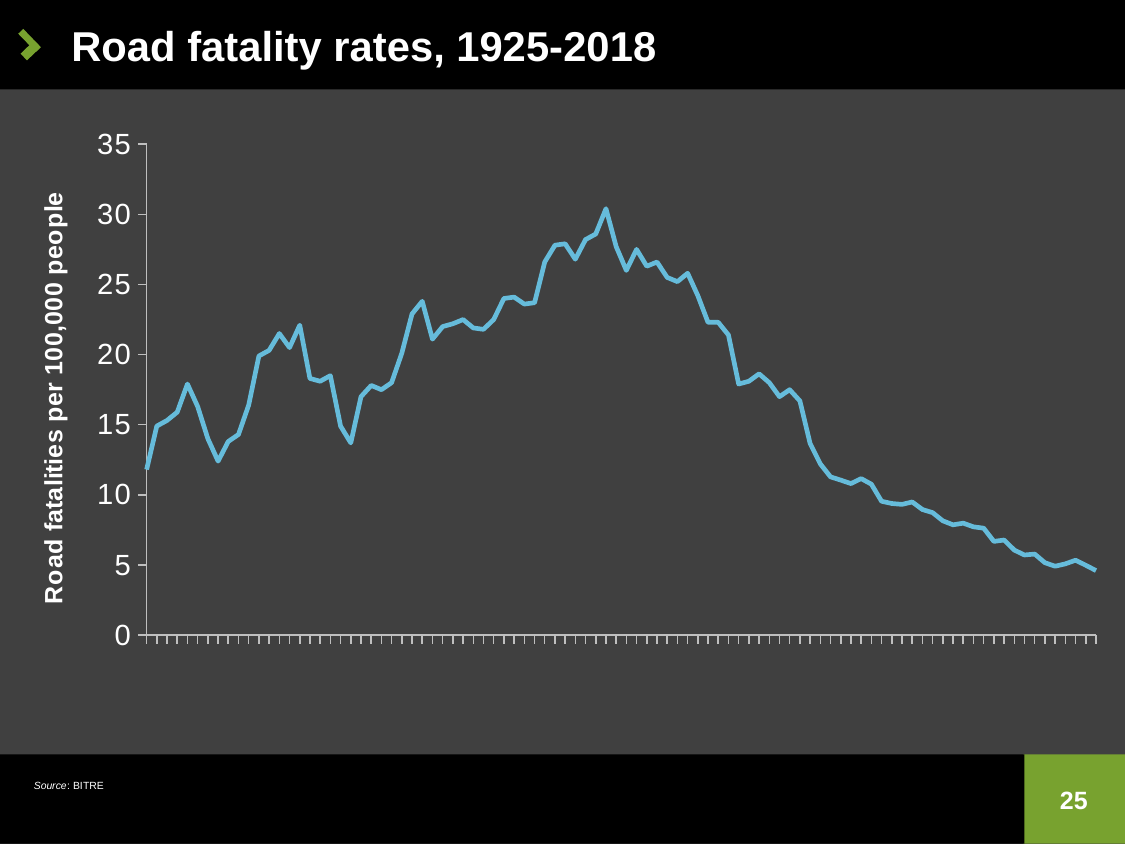
After reaching its peak, do the values along the x axis rise or fall towards the end of the series? fall Does the line end higher or lower than it starts? lower Is the value at the end of the series (2018) greater or less than 10? less Is the highest value reached by the line greater or less than 25? greater What kind of chart is shown on the slide? line chart Which is higher, the road fatality rate at the start of the series (1925) or at the end (2018)? 1925 Is the value at the start of the series (1925) greater or less than 15? less What is the title of the chart on the slide? Road fatality rates, 1925-2018 What is the label on the vertical axis of the chart? Road fatalities per 100,000 people